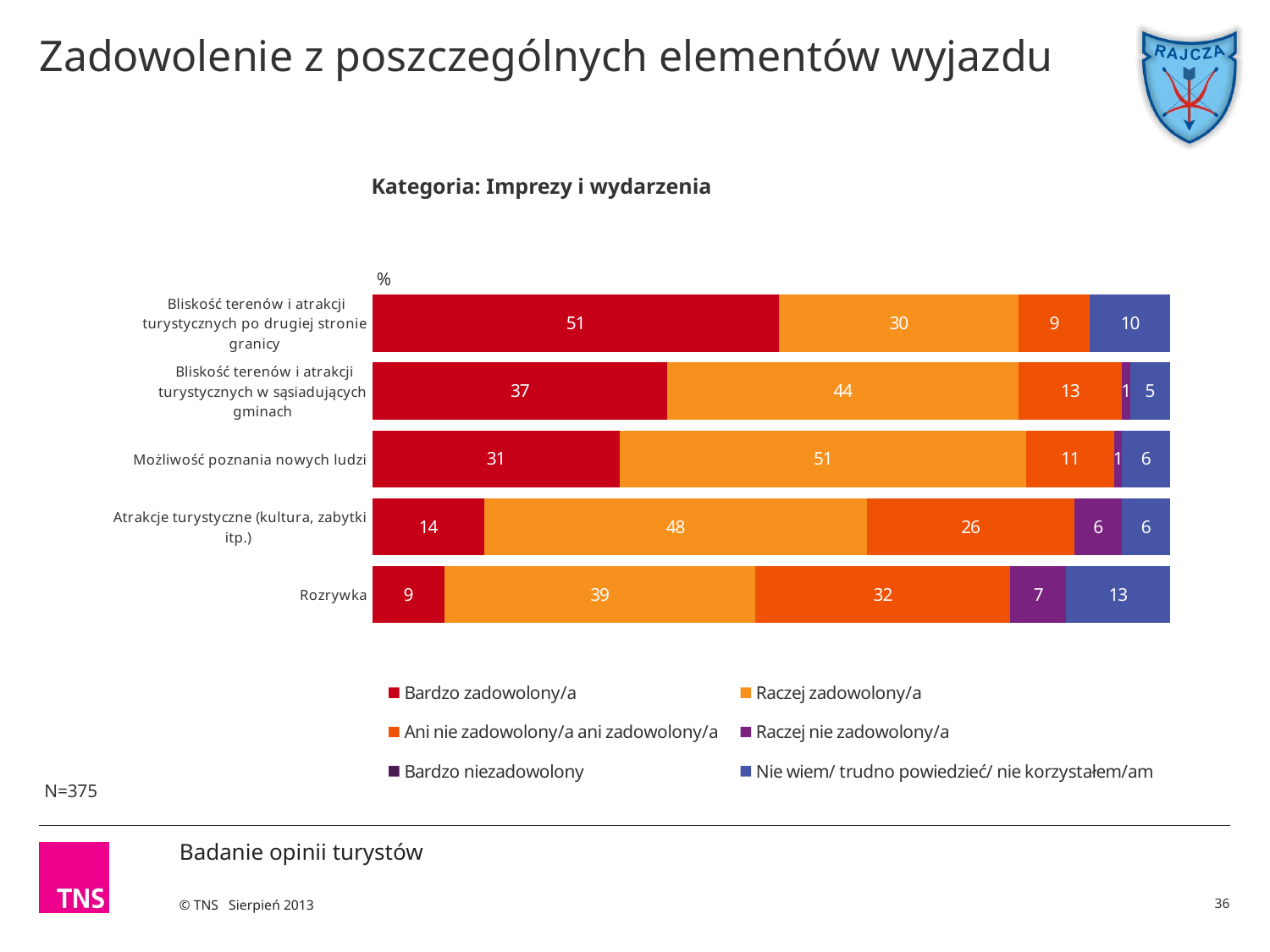
How many series does the legend list? 6 What kind of chart is shown on the slide? Stacked bar chart Which category has the highest "Bardzo zadowolony/a" value? Bliskość terenów i atrakcji turystycznych po drugiej stronie granicy What percentage of respondents were "Bardzo zadowolony/a" with "Bliskość terenów i atrakcji turystycznych po drugiej stronie granicy"? 51 What is the total of the stacked bar for "Rozrywka"? 100 How many categories are shown on the chart? 5 What is the "Nie wiem/ trudno powiedzieć/ nie korzystałem/am" value for "Rozrywka"? 13 Which category has the lowest "Bardzo zadowolony/a" value? Rozrywka What is the "Ani nie zadowolony/a ani zadowolony/a" value for "Atrakcje turystyczne (kultura, zabytki itp.)"? 26 What is the difference between the "Raczej zadowolony/a" values for "Atrakcje turystyczne (kultura, zabytki itp.)" and "Rozrywka"? 9 What is the "Raczej zadowolony/a" value for "Możliwość poznania nowych ludzi"? 51 Which is larger: the "Ani nie zadowolony/a ani zadowolony/a" value for "Rozrywka" or for "Bliskość terenów i atrakcji turystycznych w sąsiadujących gminach"? Rozrywka